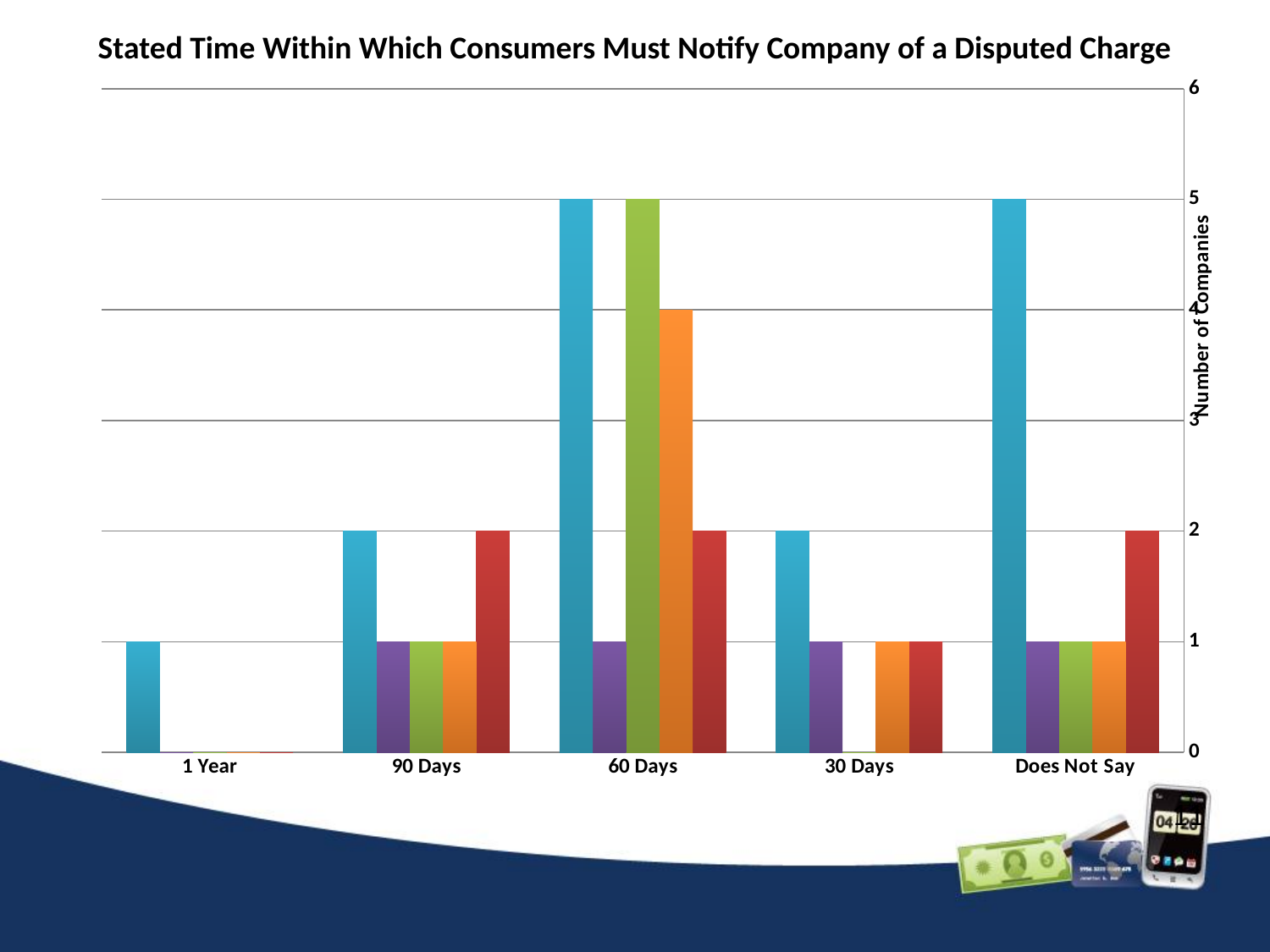
What is the value of the blue bar for 1 Year? 1 What is the value of the red bar for 90 Days? 2 Which is larger for 60 Days, the orange bar or the red bar? orange bar What is the value of the blue bar for Does Not Say? 5 Is the value of the green bar for 60 Days greater or less than 3? greater What is the label of the vertical axis? Number of Companies What is the difference between the blue bar and the purple bar for 60 Days? 4 What type of chart is shown on the slide? bar chart What is the value of the orange bar for 60 Days? 4 How many categories are shown on the x axis? 5 What is the title of the chart? Stated Time Within Which Consumers Must Notify Company of a Disputed Charge Which category has the fewest bars plotted? 1 Year